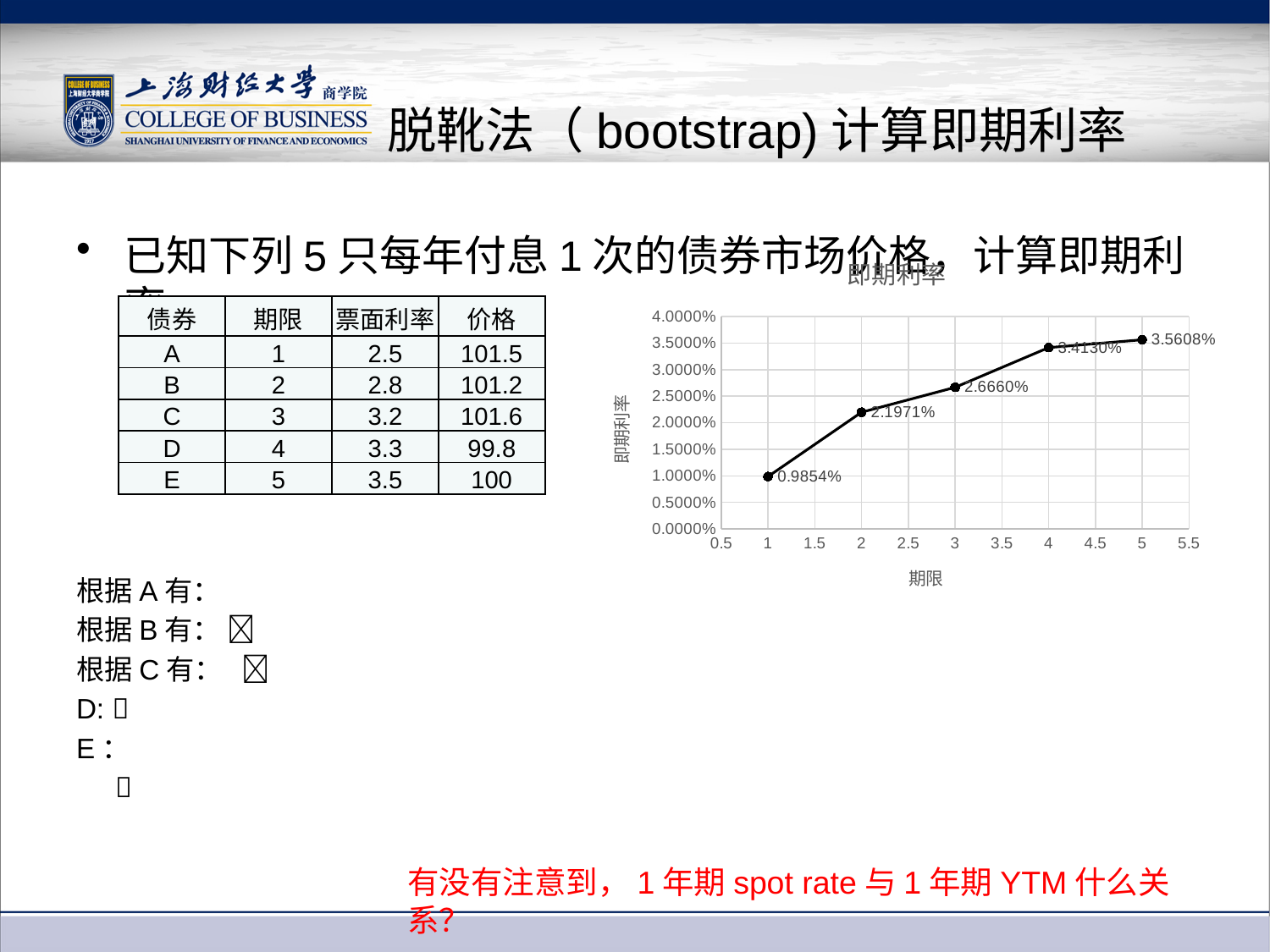
Which has the larger spot rate, 期限 3 or 期限 2? 期限 3 Which 期限 has the lowest spot rate in the chart? 1 How many data points are plotted in the chart? 5 What is the difference between the spot rates for 期限 2 and 期限 1? 1.2117% What is the spot rate plotted for 期限 5 in the chart? 3.5608% What is the spot rate (即期利率) plotted for 期限 1 in the chart? 0.9854% What is the difference between the spot rates for 期限 5 and 期限 3? 0.8948% What is the spot rate plotted for 期限 2 in the chart? 2.1971% What kind of chart is shown on the slide? line chart Is the spot rate for 期限 4 greater or less than 3.0000%? greater What is the spot rate plotted for 期限 3 in the chart? 2.6660% Which 期限 has the highest spot rate in the chart? 5